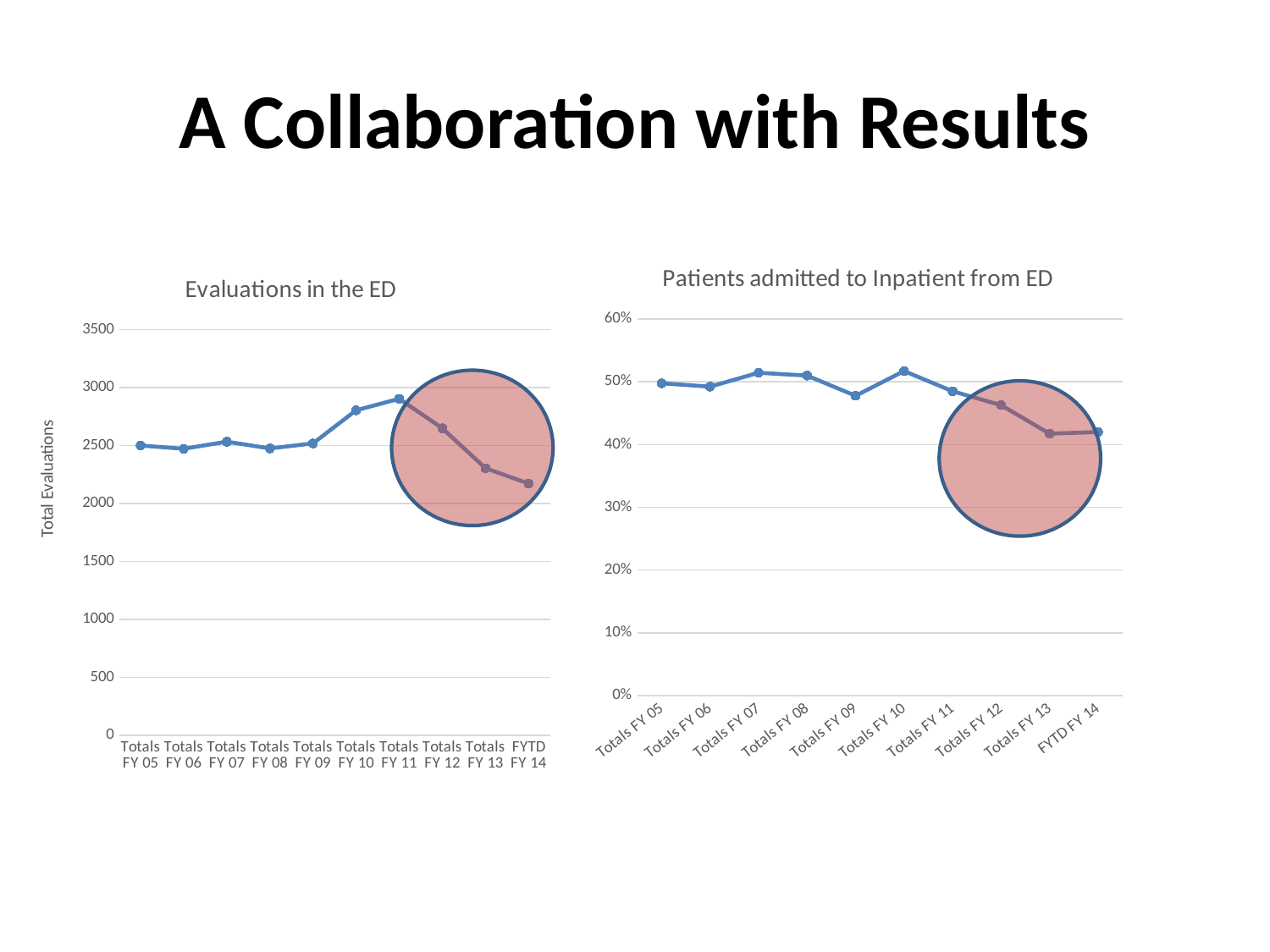
In the 'Patients admitted to Inpatient from ED' chart, how many fiscal year categories are shown on the x axis? 10 In the 'Evaluations in the ED' chart, which fiscal year has the lowest value? FYTD FY 14 In the 'Evaluations in the ED' chart, is the value for Totals FY 11 greater or less than 2500? greater In the 'Patients admitted to Inpatient from ED' chart, which is larger, the value for Totals FY 07 or Totals FY 13? Totals FY 07 In the 'Evaluations in the ED' chart, which fiscal year has the highest value? Totals FY 11 In the 'Evaluations in the ED' chart, how many data points are plotted? 10 What kind of chart is the 'Patients admitted to Inpatient from ED' chart? line chart In the 'Patients admitted to Inpatient from ED' chart, is the value for Totals FY 13 greater or less than 50%? less In the 'Patients admitted to Inpatient from ED' chart, is the value for Totals FY 07 greater or less than 50%? greater What kind of chart is the 'Evaluations in the ED' chart? line chart What is the y-axis label of the 'Evaluations in the ED' chart? Total Evaluations